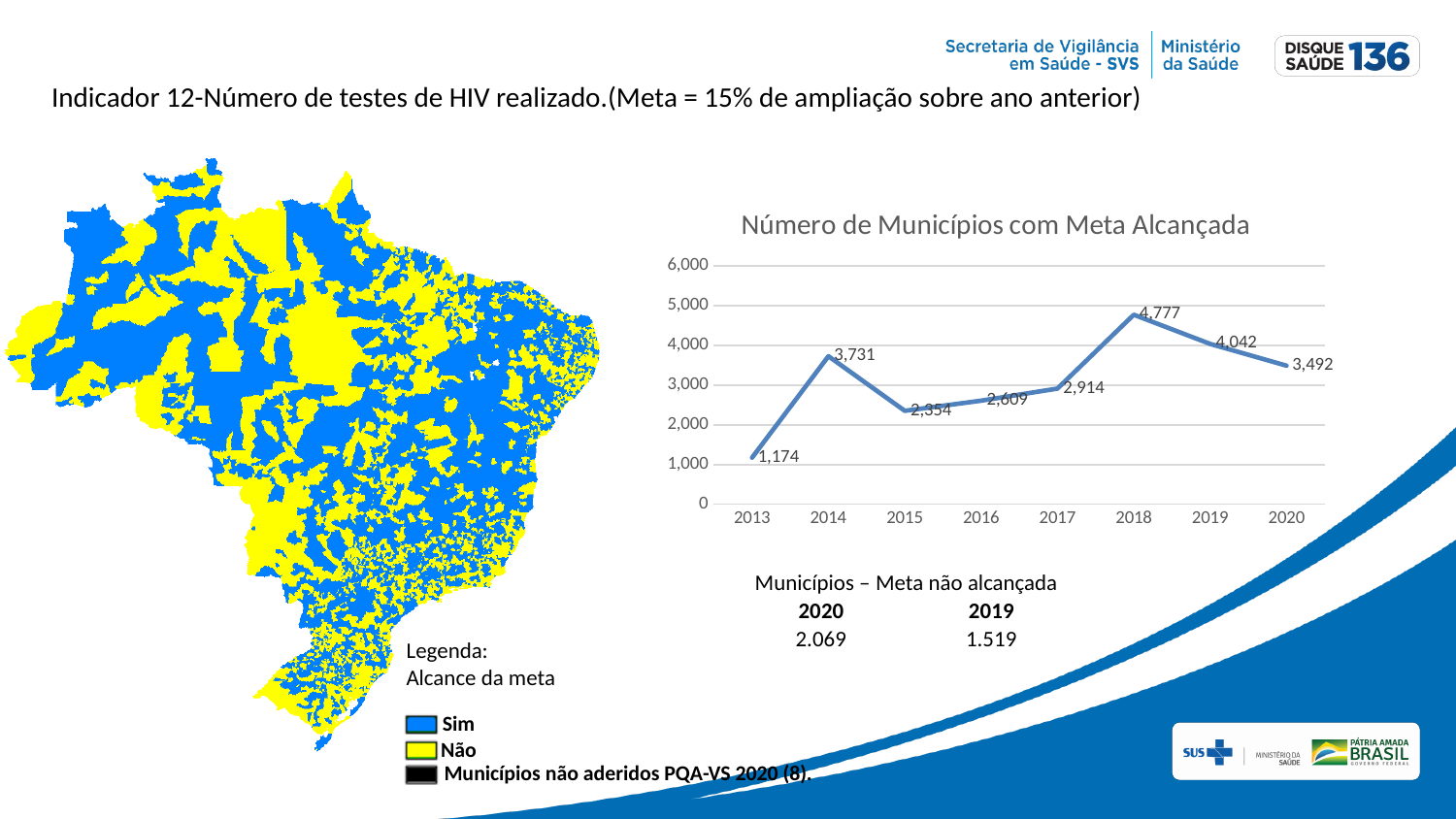
What is the title of the line chart on the slide? Número de Municípios com Meta Alcançada What kind of chart is 'Número de Municípios com Meta Alcançada'? line chart In the chart 'Número de Municípios com Meta Alcançada', what is the value for 2020? 3,492 In the chart 'Número de Municípios com Meta Alcançada', is the value for 2015 greater or less than 3,000? less In the chart 'Número de Municípios com Meta Alcançada', do the values rise or fall from 2018 to 2020? fall In the chart 'Número de Municípios com Meta Alcançada', which year has the highest value? 2018 How many years are plotted in the chart 'Número de Municípios com Meta Alcançada'? 8 In the chart 'Número de Municípios com Meta Alcançada', what is the value for 2018? 4,777 In the chart 'Número de Municípios com Meta Alcançada', what is the value for 2013? 1,174 In the chart 'Número de Municípios com Meta Alcançada', which year has the lowest value? 2013 In the chart 'Número de Municípios com Meta Alcançada', which is larger, the value for 2014 or the value for 2017? 2014 In the chart 'Número de Municípios com Meta Alcançada', what is the difference between the values for 2018 and 2019? 735